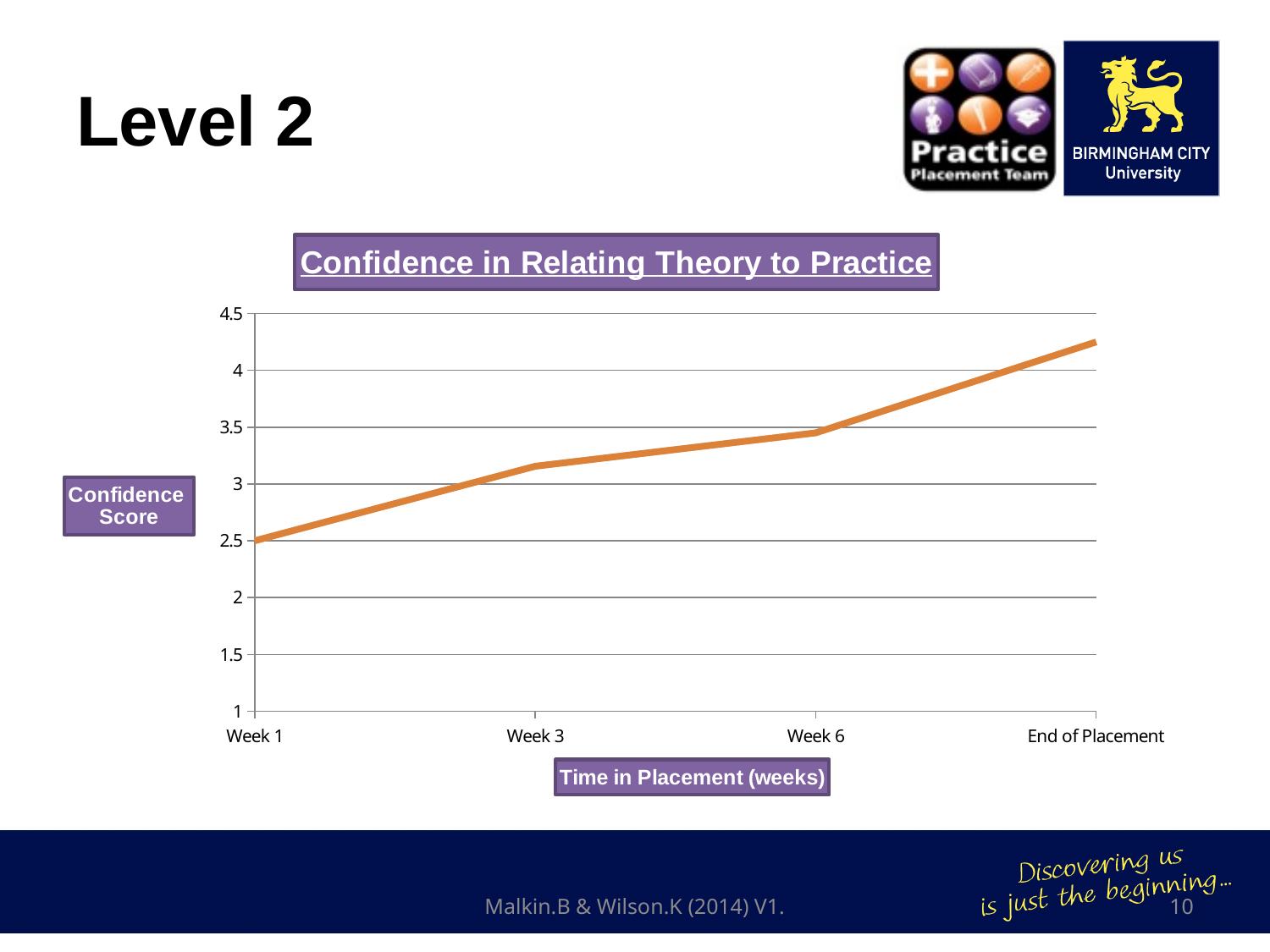
What is the confidence score at Week 1? 2.5 How many time points are plotted on the x axis? 4 At which time point is the confidence score highest? End of Placement Does the confidence score rise or fall from Week 1 to End of Placement? rise What is the title of the chart? Confidence in Relating Theory to Practice At which time point is the confidence score lowest? Week 1 Is the confidence score at End of Placement greater or less than 4? greater Which has the higher confidence score, Week 3 or Week 6? Week 6 What kind of chart is shown on the slide? line chart What is the label on the x axis of the chart? Time in Placement (weeks) Is the confidence score at Week 3 greater or less than 3? greater